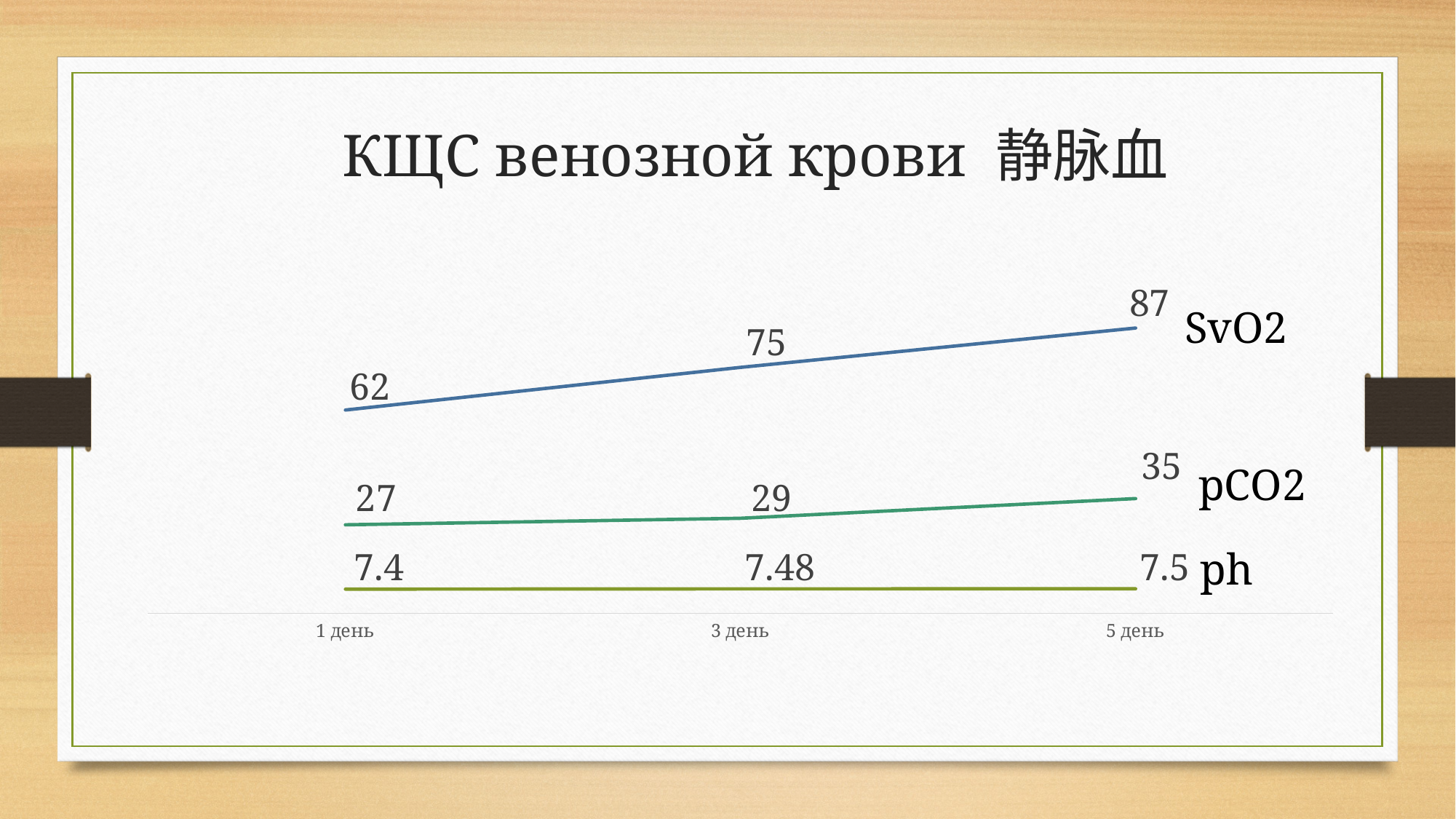
What is the pCO2 value on 5 день? 35 What is the ph value on 3 день? 7.48 What is the difference between the pCO2 values on 5 день and 3 день? 6 On which day is SvO2 highest? 5 день What is the ph value on 1 день? 7.4 What is the difference between the SvO2 values on 5 день and 1 день? 25 On which day is pCO2 lowest? 1 день Which is larger, SvO2 on 1 день or pCO2 on 5 день? SvO2 on 1 день How many days (categories) are shown on the x axis? 3 How many series are plotted on the chart? 3 What is the SvO2 value on 3 день? 75 What kind of chart is shown on the slide? line chart